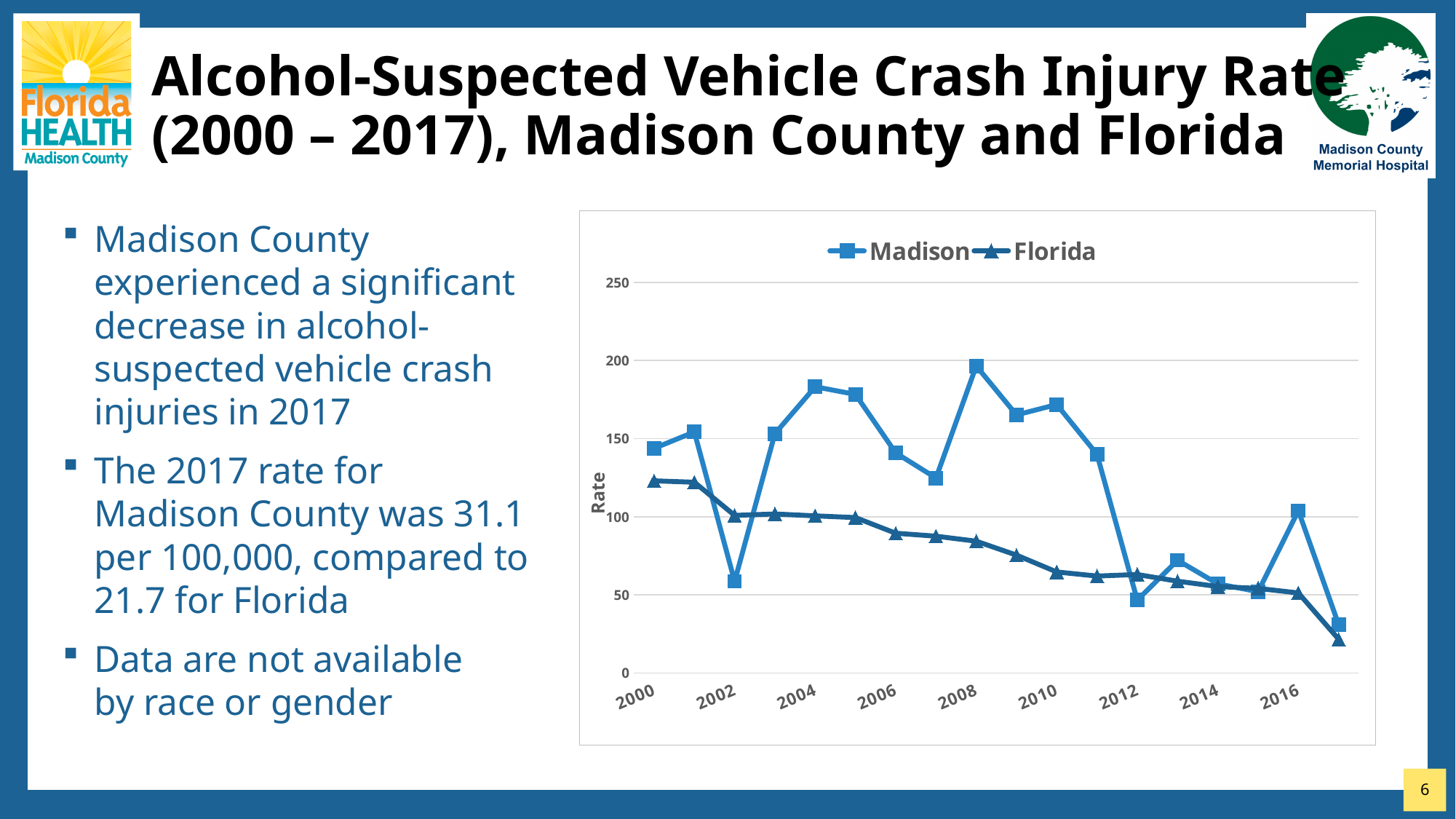
Is the Madison value for 2002 greater or less than 100? less Is the Florida value for 2017 greater or less than 50? less What are the two series named in the chart legend? Madison and Florida In which year does the Madison series reach its highest value? 2008 In which year does the Madison series reach its lowest value? 2017 Does the Florida series generally rise or fall from 2000 to 2017? fall Is the Madison value for 2008 greater or less than 150? greater What kind of chart is shown on the slide? line chart In 2008, which series has the higher value, Madison or Florida? Madison What is the label on the vertical axis of the chart? Rate How many series does the chart legend list? 2